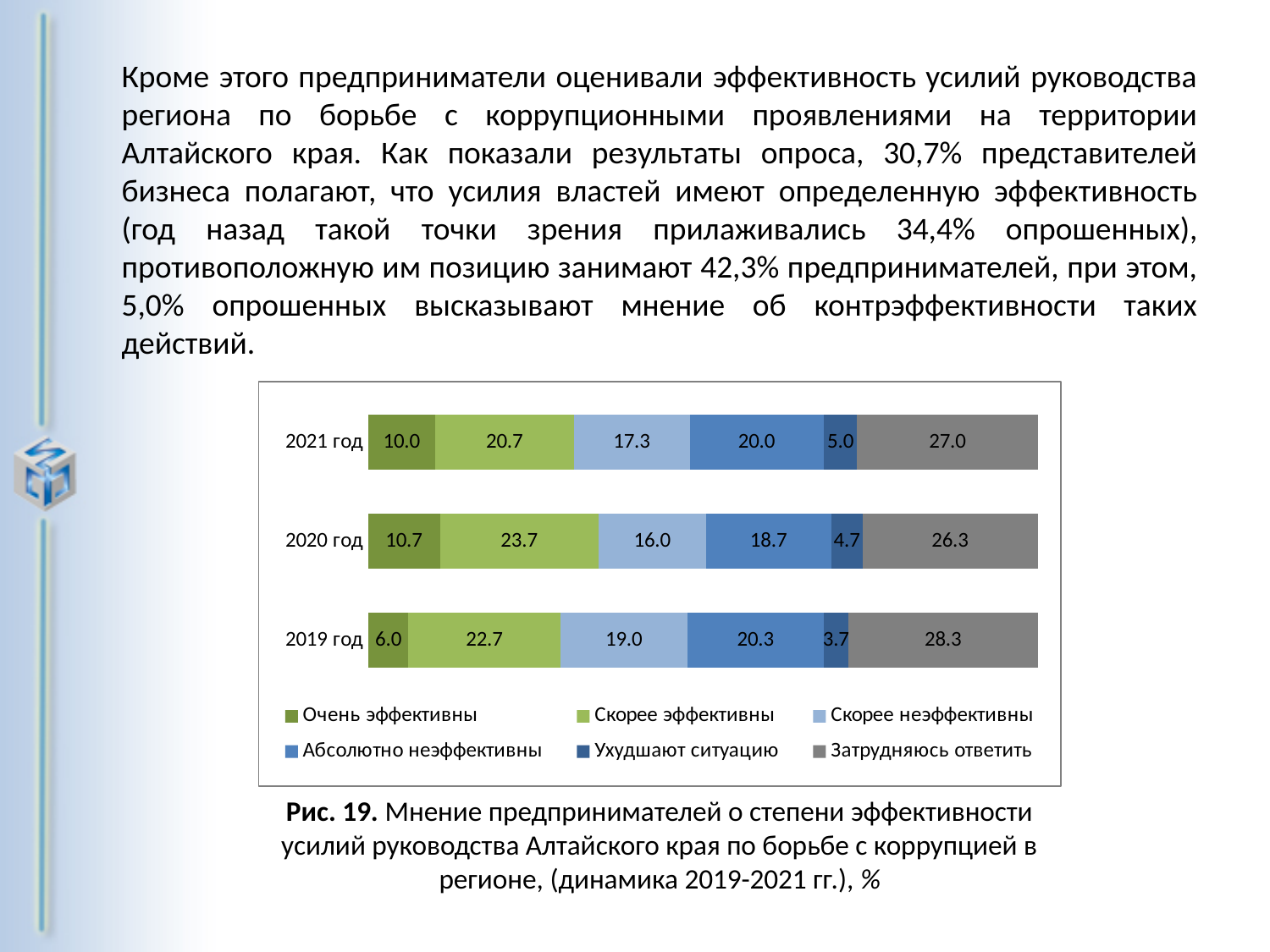
Which year has the larger value for «Очень эффективны», 2021 год or 2020 год? 2020 год What is the total of the stacked bar for 2021 год? 100.0 Which year has the highest value for «Скорее неэффективны»? 2019 год What is the value for «Затрудняюсь ответить» in 2021 год? 27.0 What is the value for «Скорее эффективны» in 2020 год? 23.7 What is the difference between the «Абсолютно неэффективны» values for 2021 год and 2020 год? 1.3 What kind of chart is shown on the slide? Stacked bar chart Which year has the lowest value for «Ухудшают ситуацию»? 2019 год What is the value for «Очень эффективны» in 2019 год? 6.0 Does the value for «Ухудшают ситуацию» rise or fall from 2019 год to 2021 год? Rise How many years (categories) are shown in the chart? 3 How many series does the legend list? 6